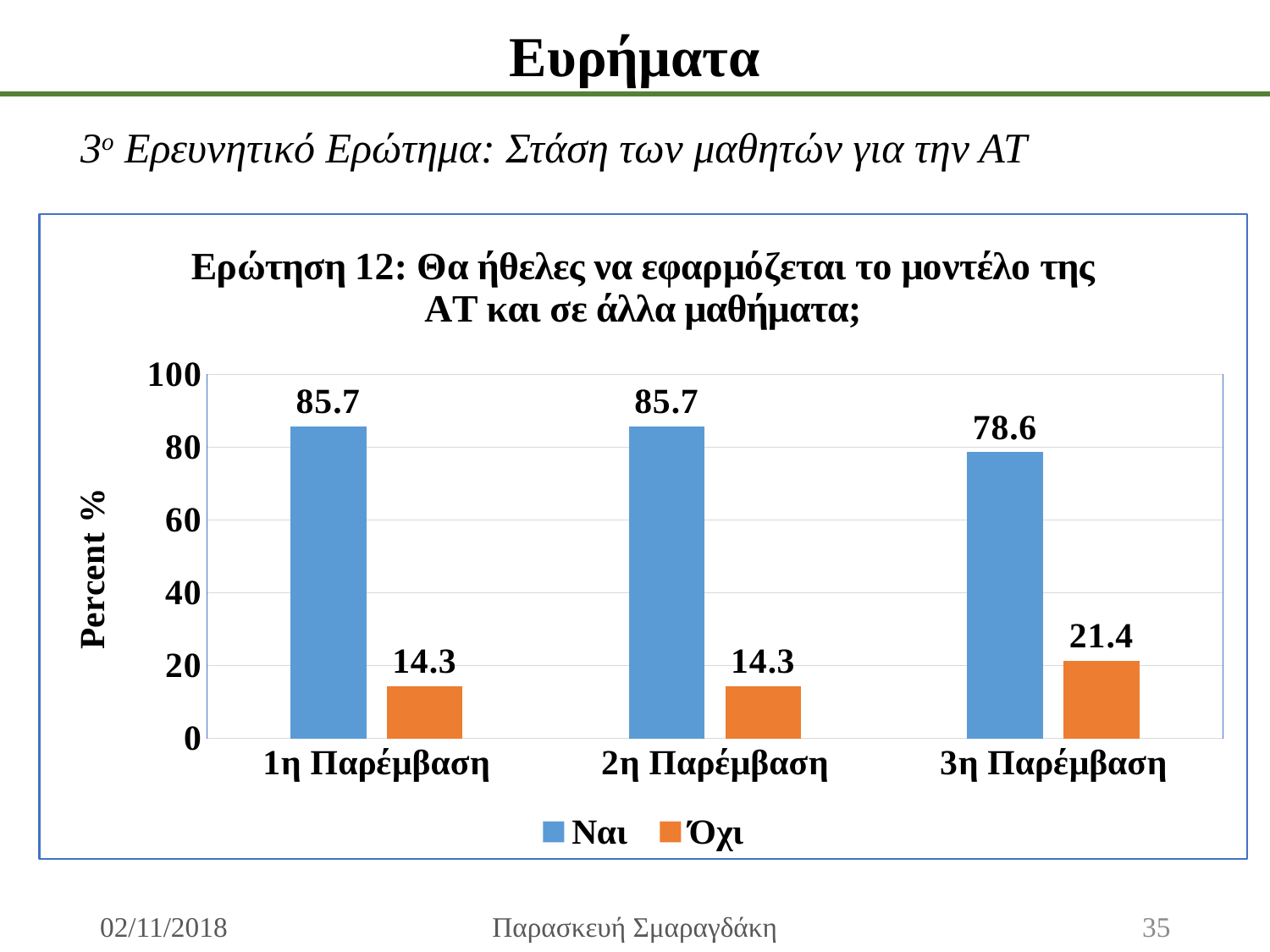
What is the difference between Ναι and Όχι in 2η Παρέμβαση? 71.4 Which category has the lowest value for Ναι? 3η Παρέμβαση What kind of chart is shown? bar chart What is the label of the y axis? Percent % What is the value for Ναι in 3η Παρέμβαση? 78.6 How many categories are shown on the x axis? 3 What is the value for Ναι in 1η Παρέμβαση? 85.7 What is the value for Όχι in 3η Παρέμβαση? 21.4 What is the difference between the Ναι values for 1η Παρέμβαση and 3η Παρέμβαση? 7.1 Which category has the highest value for Όχι? 3η Παρέμβαση How many series does the legend list? 2 Which is larger in 3η Παρέμβαση, Ναι or Όχι? Ναι